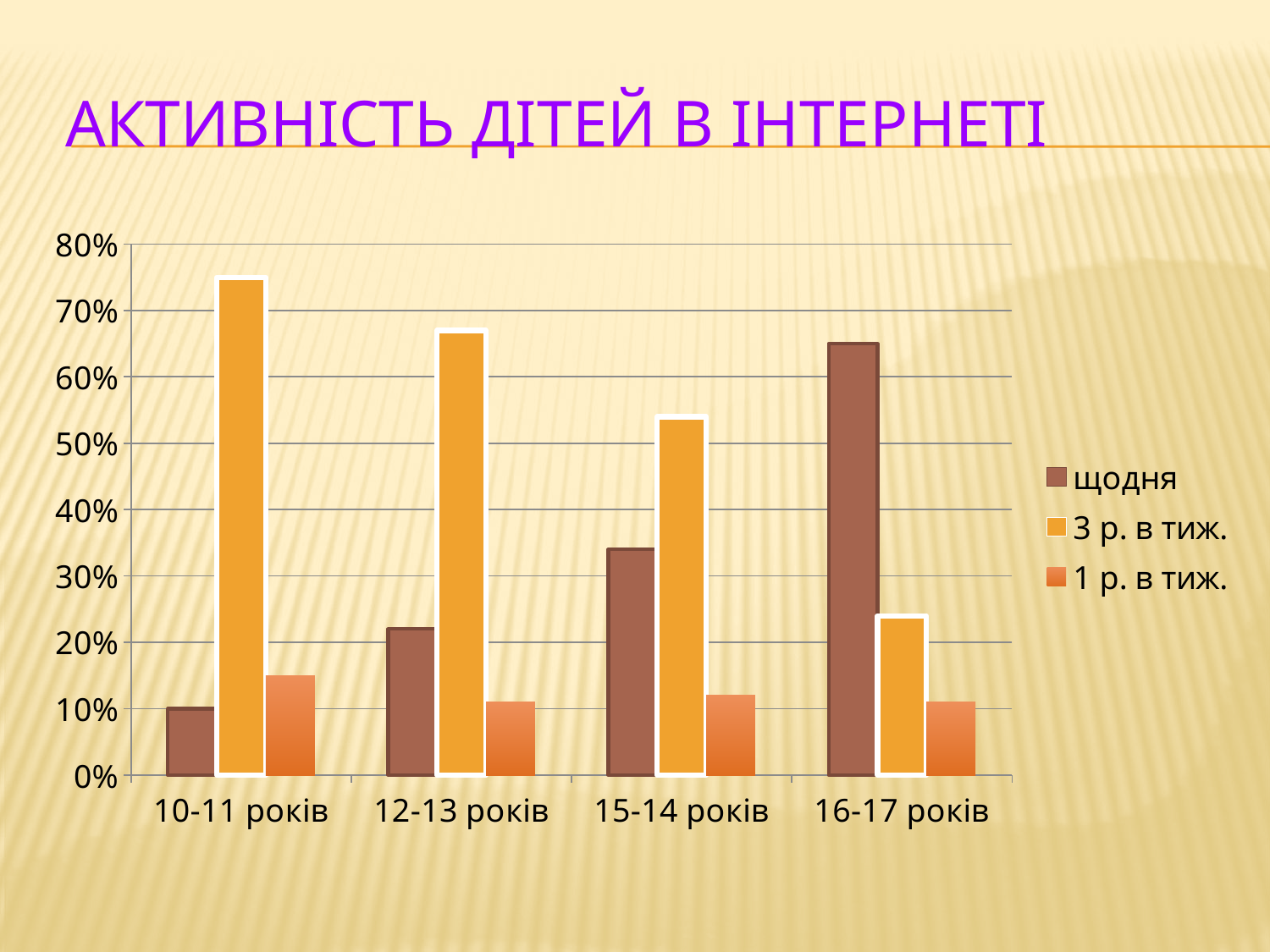
Is the value for "1 р. в тиж." in the 12-13 років group greater or less than 20%? less How many age groups are shown on the x axis? 4 Does the "щодня" series rise or fall across the age groups from left to right? rise Which age group has the lowest value for the "3 р. в тиж." series? 16-17 років Is the value for "щодня" in the 16-17 років group greater or less than 60%? greater Which is larger in the 15-14 років group: "щодня" or "3 р. в тиж."? 3 р. в тиж. Which age group has the lowest value for the "щодня" series? 10-11 років What kind of chart is shown on the slide? bar chart Is the value for "3 р. в тиж." in the 10-11 років group greater or less than 70%? greater Which age group has the highest value for the "щодня" series? 16-17 років Which age group has the highest value for the "3 р. в тиж." series? 10-11 років How many series does the legend list? 3